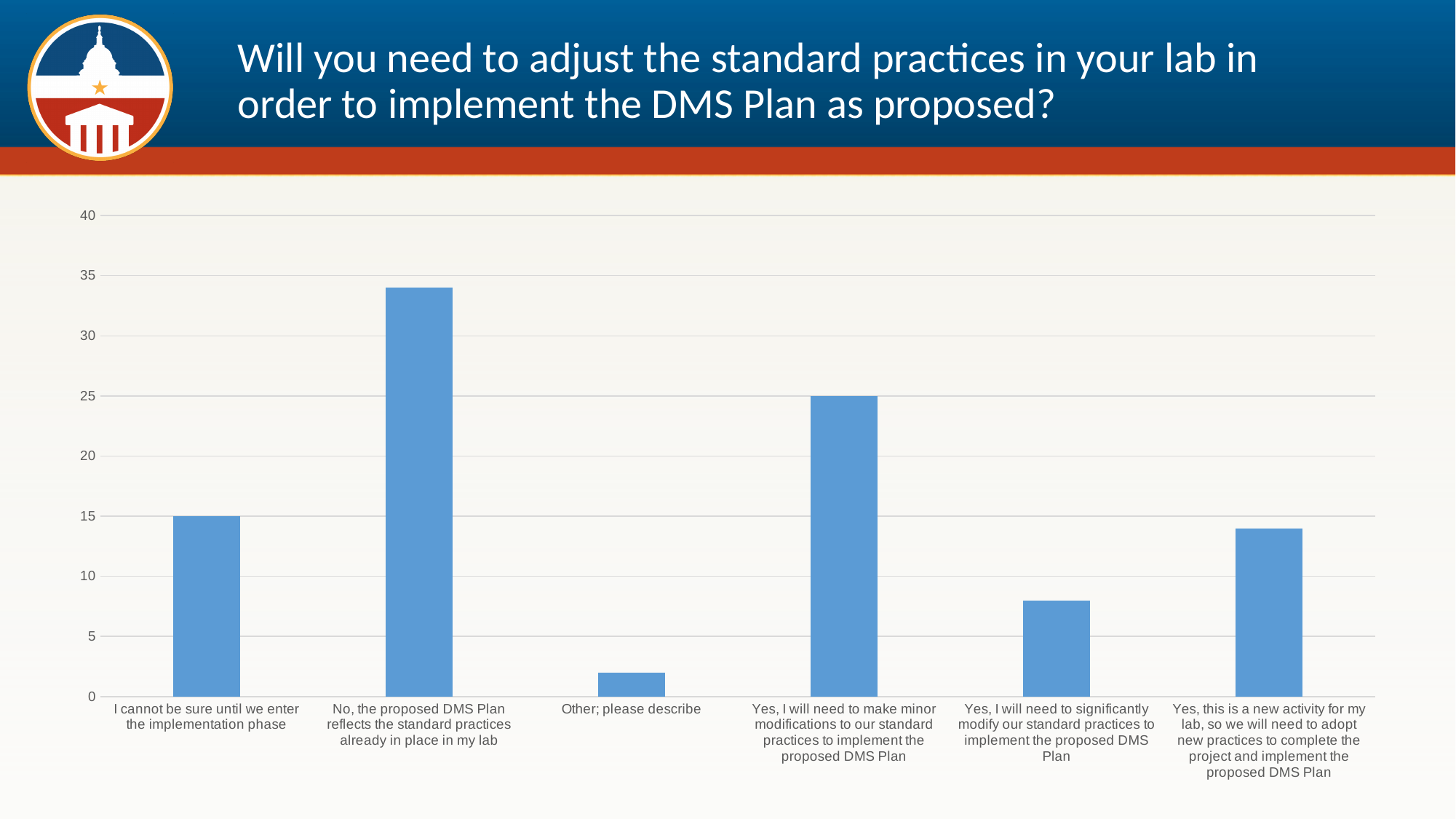
What is the value for "Yes, I will need to make minor modifications to our standard practices to implement the proposed DMS Plan"? 25 Is the value for "Other; please describe" greater or less than 5? less What is the value for "I cannot be sure until we enter the implementation phase"? 15 Which is larger: the value for "Yes, I will need to make minor modifications to our standard practices to implement the proposed DMS Plan" or the value for "I cannot be sure until we enter the implementation phase"? Yes, I will need to make minor modifications to our standard practices to implement the proposed DMS Plan What type of chart is shown on the slide? bar chart Is the value for "No, the proposed DMS Plan reflects the standard practices already in place in my lab" greater or less than 30? greater Is the value for "Yes, this is a new activity for my lab, so we will need to adopt new practices to complete the project and implement the proposed DMS Plan" greater or less than 10? greater Which response category has the highest bar? No, the proposed DMS Plan reflects the standard practices already in place in my lab Which response category has the lowest bar? Other; please describe What is the difference between the value for "Yes, I will need to make minor modifications to our standard practices to implement the proposed DMS Plan" and the value for "I cannot be sure until we enter the implementation phase"? 10 How many response categories are shown on the x axis? 6